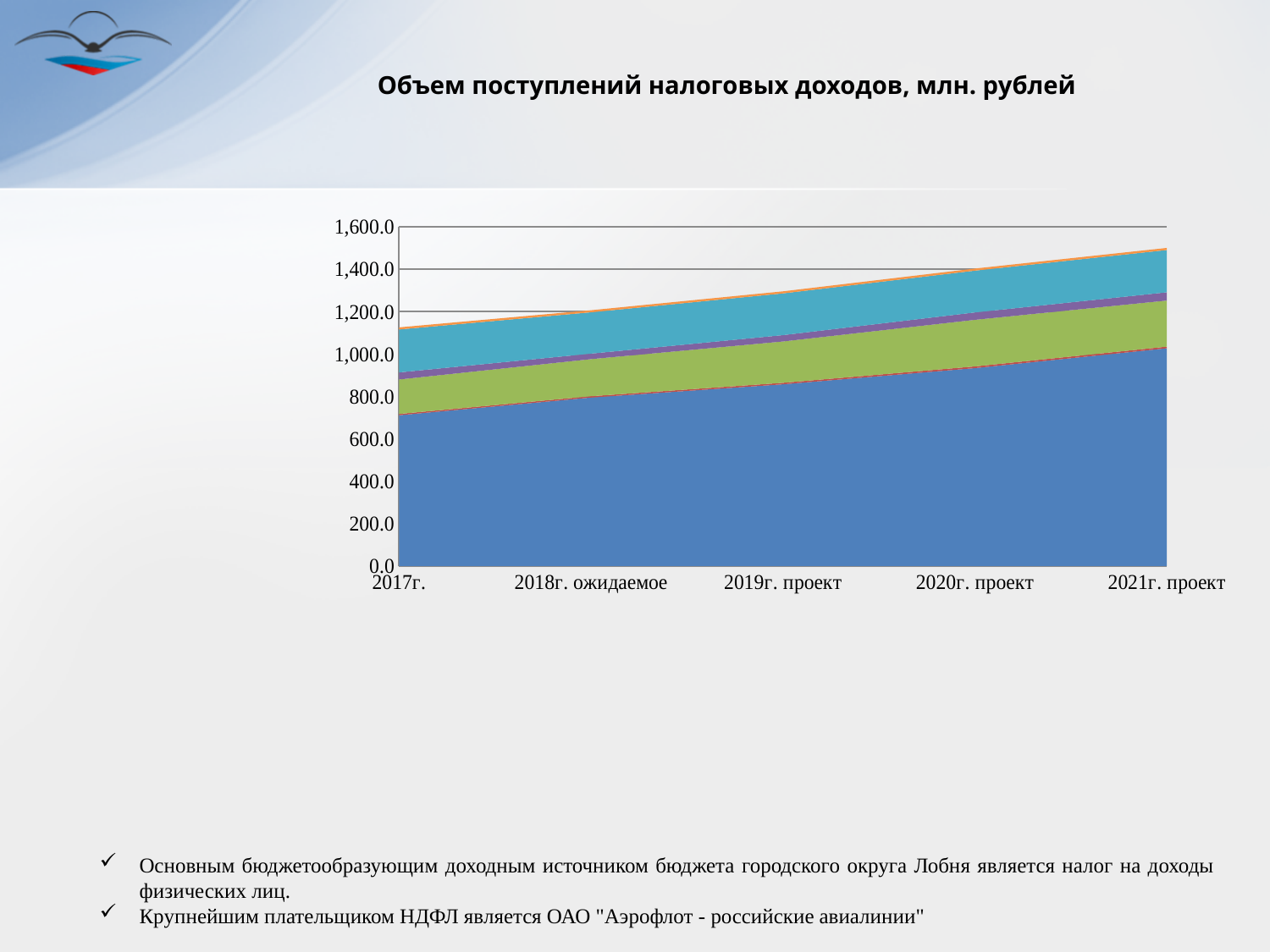
Is the value of the bottom (blue) series for 2017г. greater or less than 800.0? less Is the total value for 2017г. greater or less than 1,000.0? greater Is the total value for 2019г. проект greater or less than 1,400.0? less How many years (categories) are shown along the x axis? 5 How many coloured bands (series) are stacked in the chart? 6 Is the total value larger for 2020г. проект or for 2018г. ожидаемое? 2020г. проект What is the title of the chart? Объем поступлений налоговых доходов, млн. рублей What kind of chart is shown on the slide? stacked area chart Which year has the lowest total value? 2017г. Which year has the highest total value? 2021г. проект Does the total height of the stacked areas rise or fall from 2017г. to 2021г. проект? rise